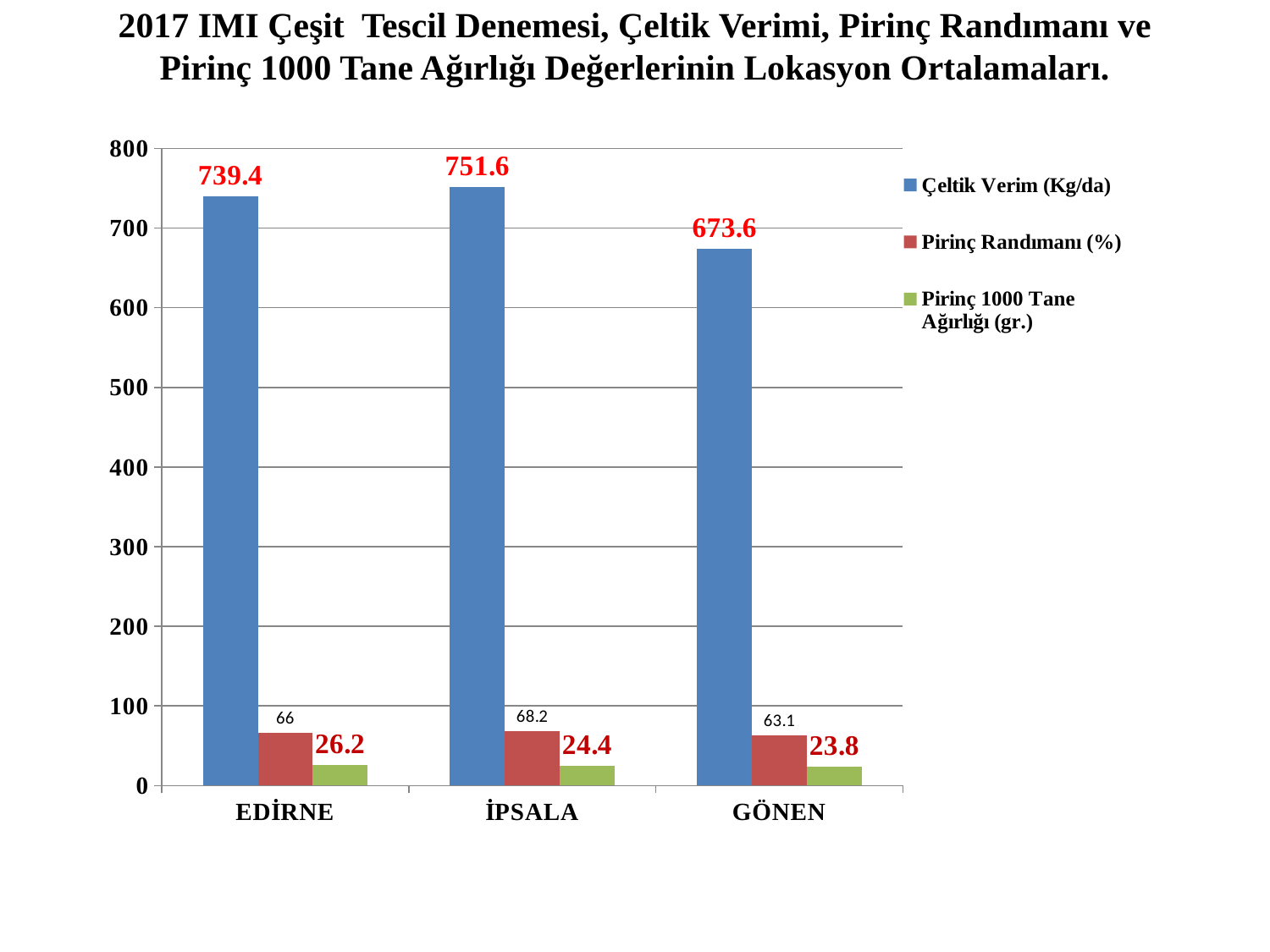
How many locations are shown on the x axis? 3 What is the Çeltik Verim (Kg/da) value for İPSALA? 751.6 What kind of chart is shown on the slide? bar chart Which colour represents Pirinç Randımanı (%) in the legend? red Which location has the highest Çeltik Verim (Kg/da)? İPSALA Is the Çeltik Verim (Kg/da) value for GÖNEN greater or less than 700? less How many series does the legend list? 3 Which location has a higher Pirinç Randımanı (%), EDİRNE or İPSALA? İPSALA What is the Pirinç 1000 Tane Ağırlığı (gr.) value for EDİRNE? 26.2 What is the Pirinç Randımanı (%) value for GÖNEN? 63.1 Which location has the lowest Pirinç 1000 Tane Ağırlığı (gr.)? GÖNEN What is the difference in Çeltik Verim (Kg/da) between EDİRNE and GÖNEN? 65.8